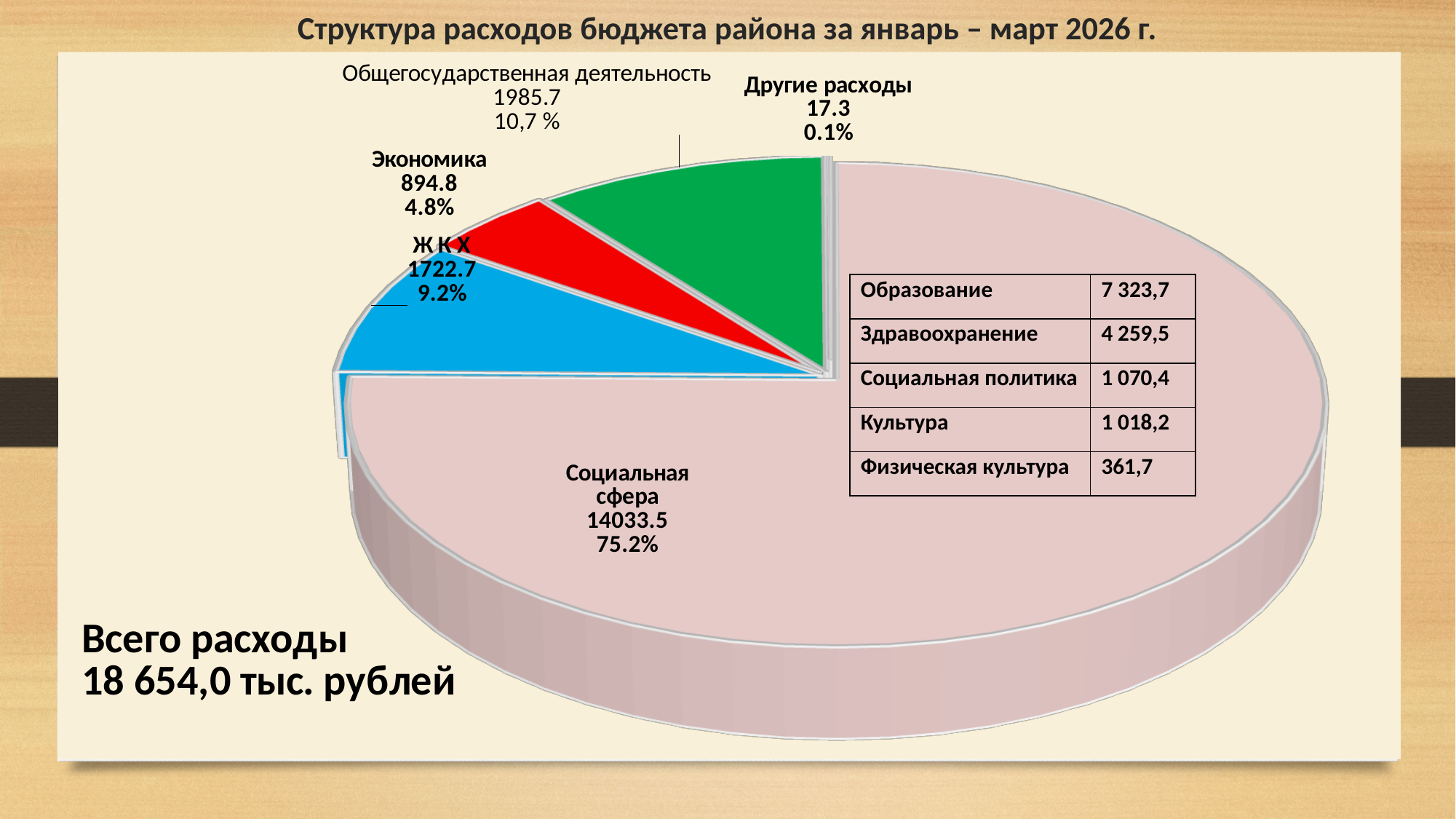
Which is larger, ЖКХ or Экономика? ЖКХ What is the value for Общегосударственная деятельность? 1985.7 Which category has the largest slice? Социальная сфера How many slices does the pie chart have? 5 What is the title of the chart? Структура расходов бюджета района за январь – март 2026 г. Which category has the smallest slice? Другие расходы What share of the pie does Социальная сфера take? 75.2% What is the value for Экономика? 894.8 What kind of chart is shown on the slide? pie chart What share of the pie does ЖКХ take? 9.2% What is the difference between the values for Общегосударственная деятельность and ЖКХ? 263.0 What is the value for Социальная сфера? 14033.5